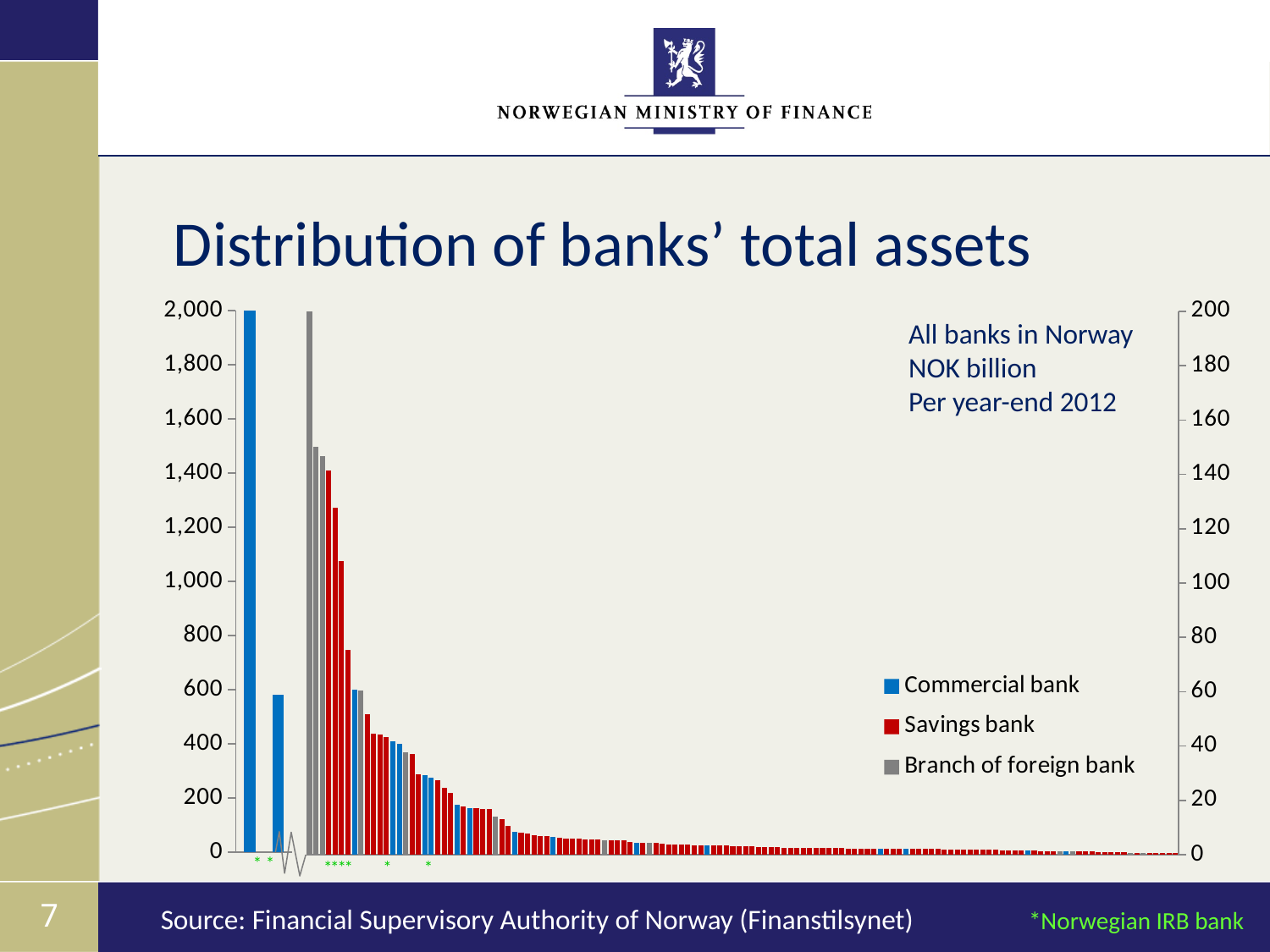
Which series contains the tallest bar in the chart? Commercial bank What are the three series named in the legend? Commercial bank, Savings bank, Branch of foreign bank What is the title of the chart? Distribution of banks' total assets Do the bar values rise or fall moving from left to right along the x axis? fall What kind of chart is shown on the slide? bar chart How many series does the legend list? 3